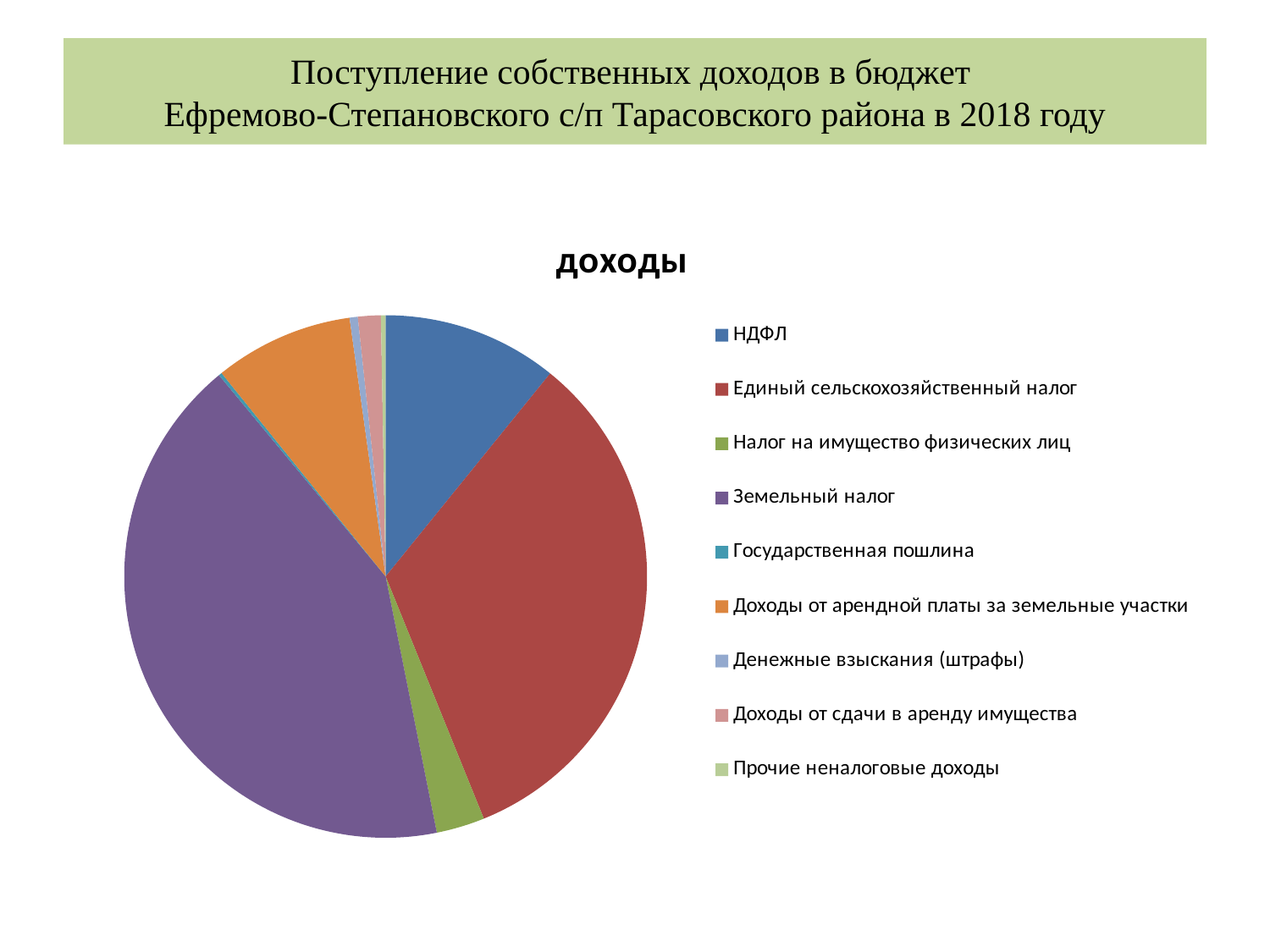
Which slice is larger: Единый сельскохозяйственный налог or НДФЛ? Единый сельскохозяйственный налог Which slice is larger: Земельный налог or Единый сельскохозяйственный налог? Земельный налог What colour is the slice for Земельный налог? purple Which slice is larger: Доходы от арендной платы за земельные участки or Доходы от сдачи в аренду имущества? Доходы от арендной платы за земельные участки Which category has the largest slice of the pie chart? Земельный налог How many categories does the legend of the pie chart list? 9 How many slices does the pie chart have? 9 What kind of chart is shown on the slide? pie chart What is the title of the chart? доходы